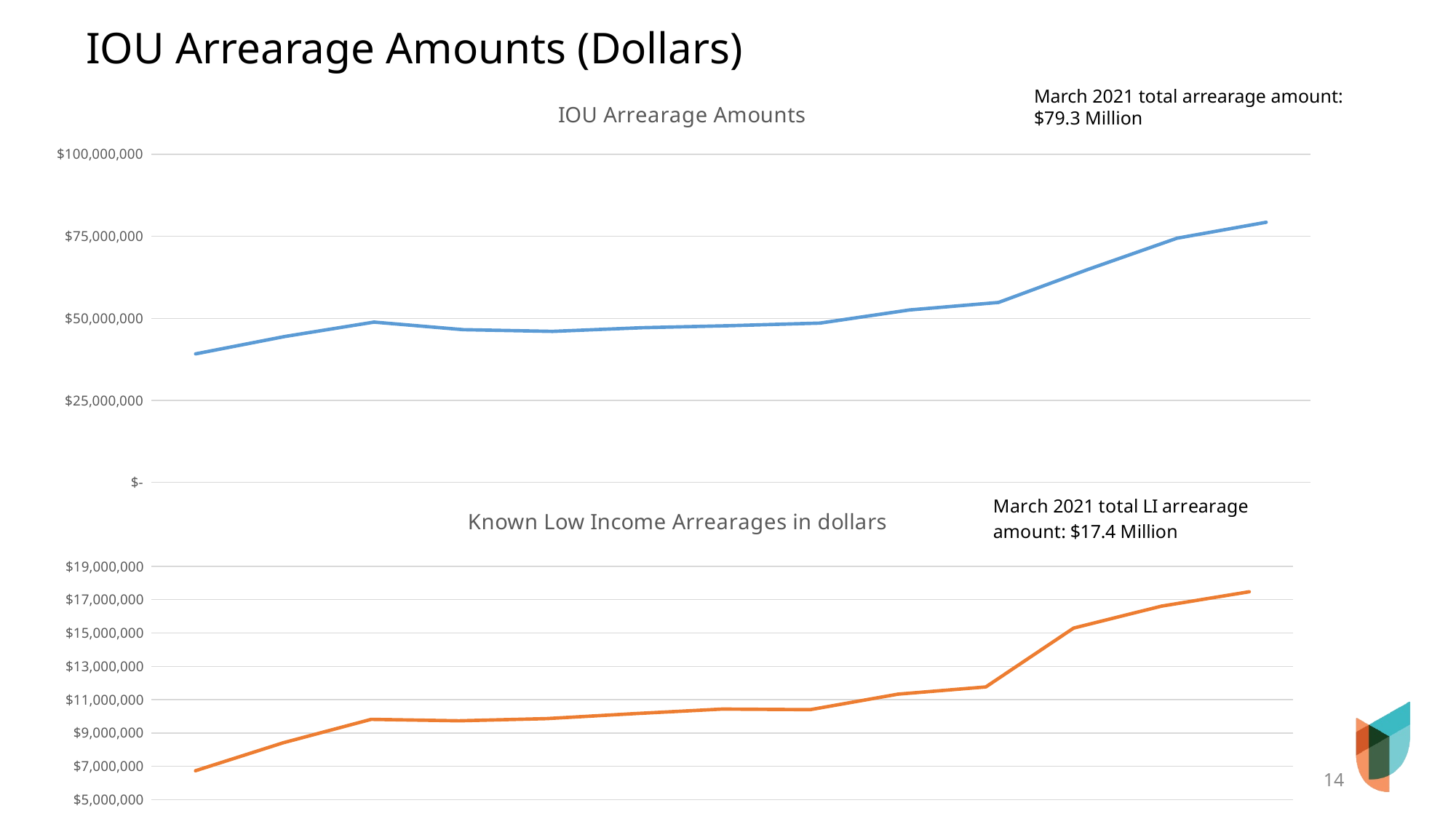
According to the annotation on the bottom chart, what is the March 2021 total LI arrearage amount? $17.4 Million In the top chart 'IOU Arrearage Amounts', do the values overall rise or fall from left to right? Rise According to the annotation on the top chart, what is the March 2021 total arrearage amount? $79.3 Million What kind of chart is the top chart titled 'IOU Arrearage Amounts'? Line chart In the top chart 'IOU Arrearage Amounts', is the value at the left end of the line greater or less than $50,000,000? less In the bottom chart 'Known Low Income Arrearages in dollars', is the value at the right end of the line greater or less than $15,000,000? greater What kind of chart is the bottom chart titled 'Known Low Income Arrearages in dollars'? Line chart In the bottom chart 'Known Low Income Arrearages in dollars', do the values overall rise or fall from left to right? Rise In the top chart 'IOU Arrearage Amounts', is the value at the right end of the line greater or less than $75,000,000? greater What is the highest value shown on the y-axis of the top chart 'IOU Arrearage Amounts'? $100,000,000 In the top chart 'IOU Arrearage Amounts', does the line reach its highest value at the left end or the right end? Right end